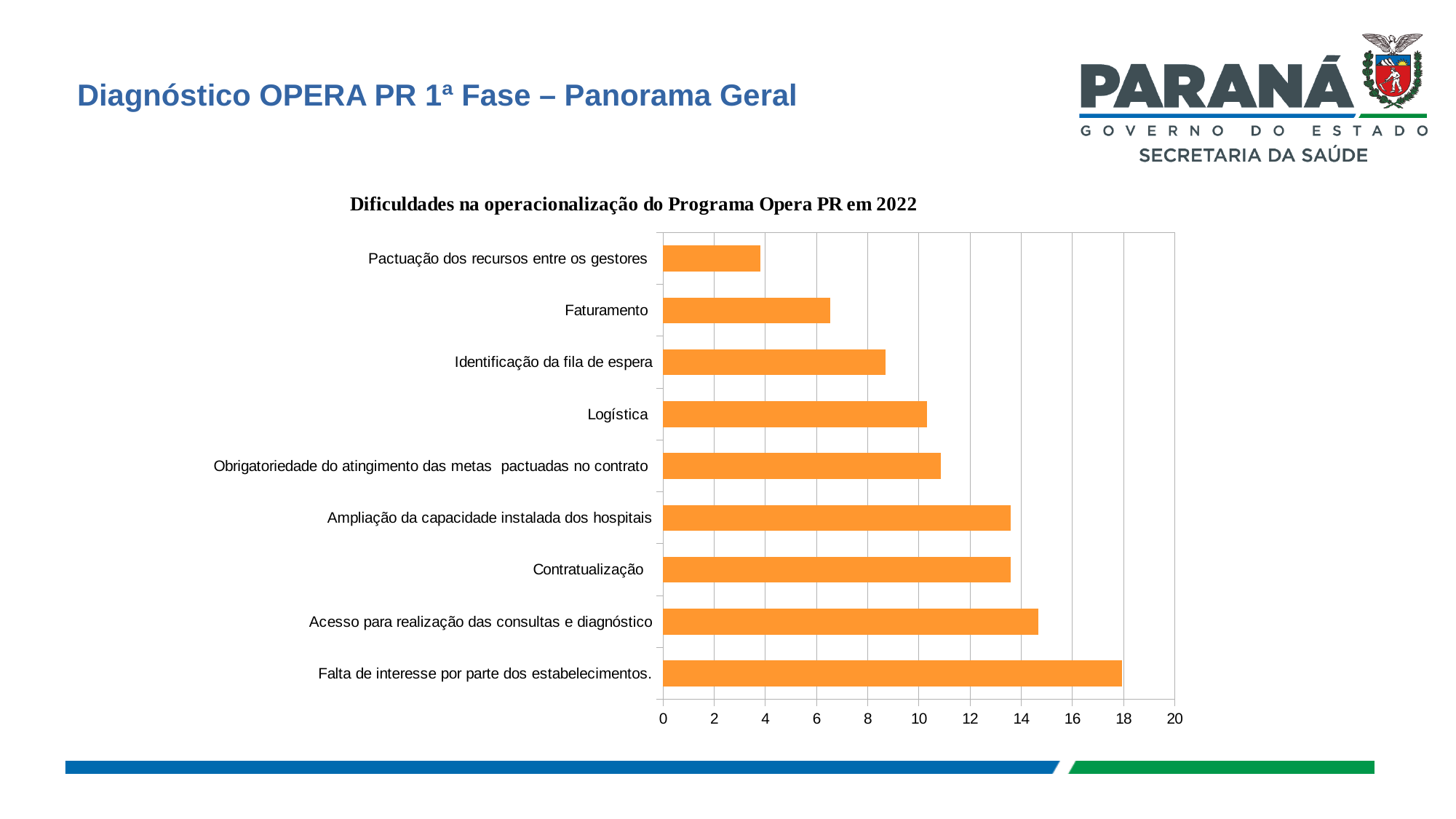
Which is larger, the value for Faturamento or the value for Identificação da fila de espera? Identificação da fila de espera What kind of chart is shown on the slide? bar chart Do the bar lengths increase or decrease going from the top category to the bottom category? increase Is the value for Acesso para realização das consultas e diagnóstico greater or less than 14? greater Is the value for Faturamento greater or less than 8? less Is the value for Falta de interesse por parte dos estabelecimentos greater or less than 16? greater How many categories are plotted in the chart? 9 Which category has the highest value? Falta de interesse por parte dos estabelecimentos. What is the title of the chart? Dificuldades na operacionalização do Programa Opera PR em 2022 Which category has the lowest value? Pactuação dos recursos entre os gestores